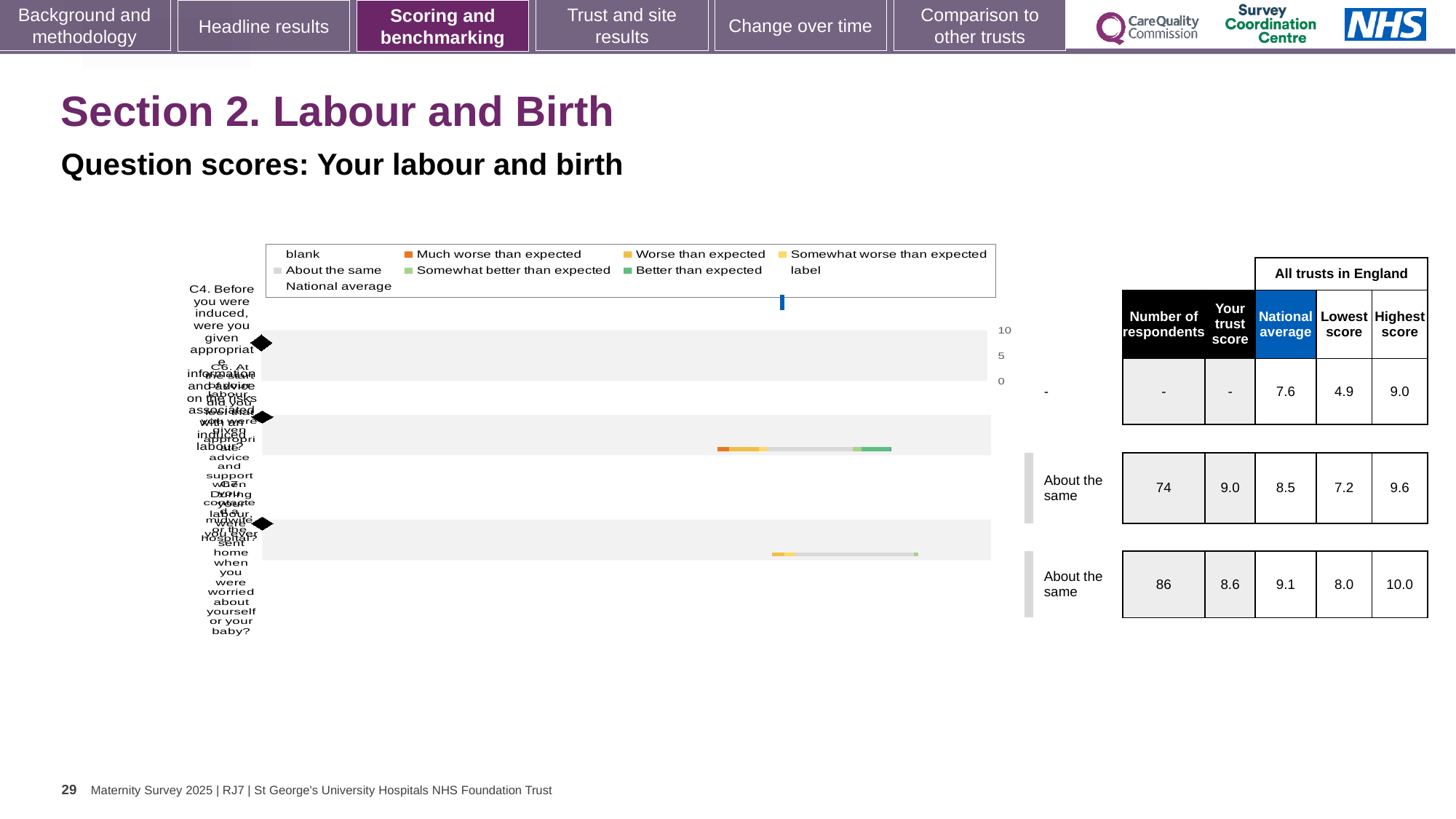
How many entries does the chart legend list? 9 In the table beside the chart, which is larger for the row with 86 respondents: the trust score or the national average? national average In the table beside the chart, what is the highest score for the first row (the one with no trust score)? 9.0 In the table beside the chart, which row has the highest 'Highest score' value? the row with 86 respondents (10.0) Which colour does the legend use for 'Much worse than expected'? orange In the table beside the chart, what is the trust score for the row with 74 respondents? 9.0 In the table beside the chart, what is the difference between the highest score and the lowest score for the row with 74 respondents? 2.4 How many question rows (categories) are plotted on the chart? 3 What kind of chart is shown on the slide? bar chart What is the highest value shown on the chart's axis? 10 In the table beside the chart, what is the national average for the row with 86 respondents? 9.1 In the table beside the chart, what is the lowest score for the first row? 4.9